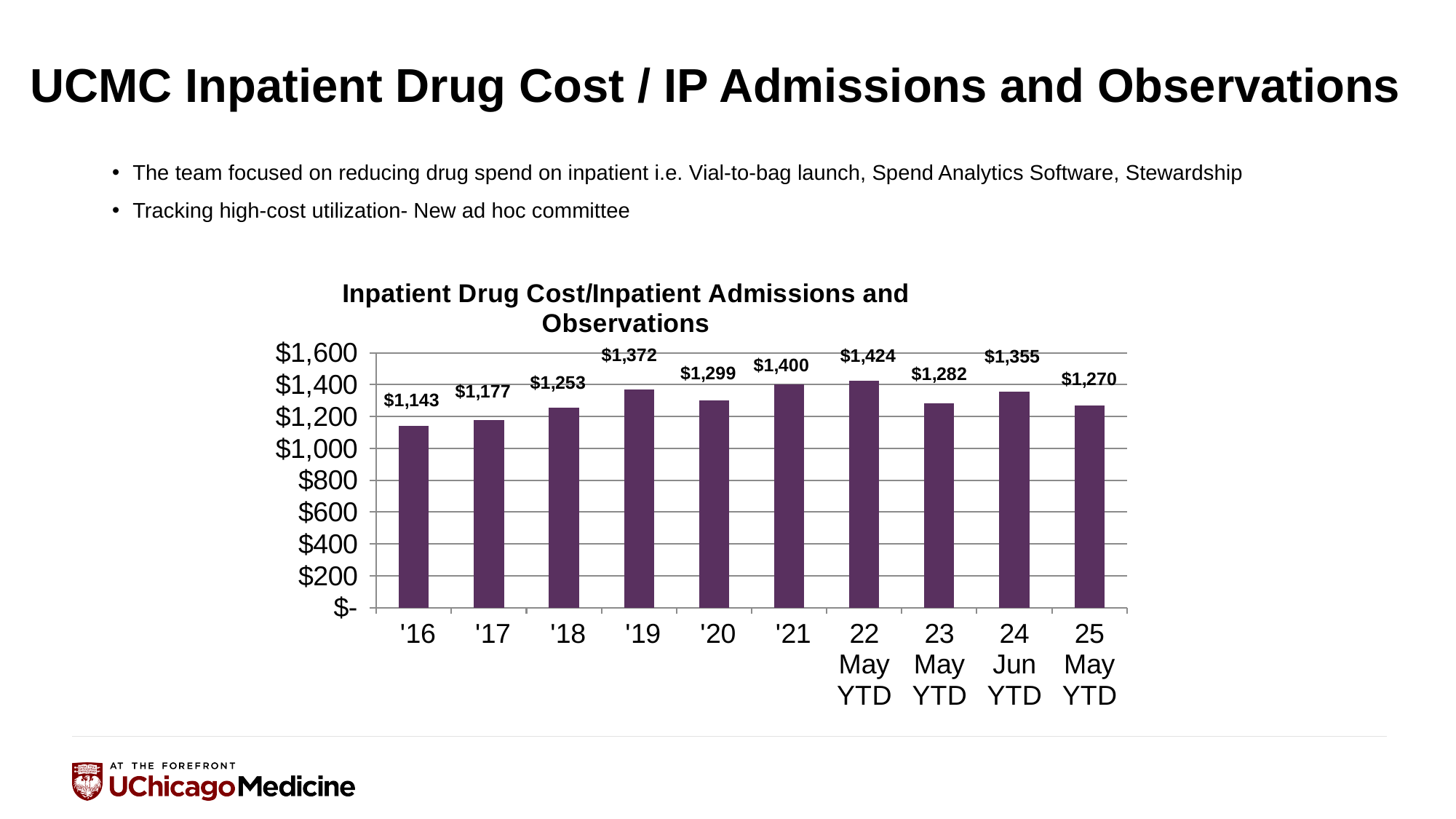
How many categories are shown on the x axis? 10 Is the value for '19 greater or less than $1,200? greater Which category has the lowest value? '16 What is the value for 25 May YTD? $1,270 Which category has the highest value? 22 May YTD What kind of chart is shown? bar chart What is the value for '16? $1,143 What is the title of the chart? Inpatient Drug Cost/Inpatient Admissions and Observations What is the difference between the values for '21 and '20? $101 What is the value for 22 May YTD? $1,424 Do the values rise or fall from '16 to '19? rise Which is larger, the value for 24 Jun YTD or the value for 23 May YTD? 24 Jun YTD